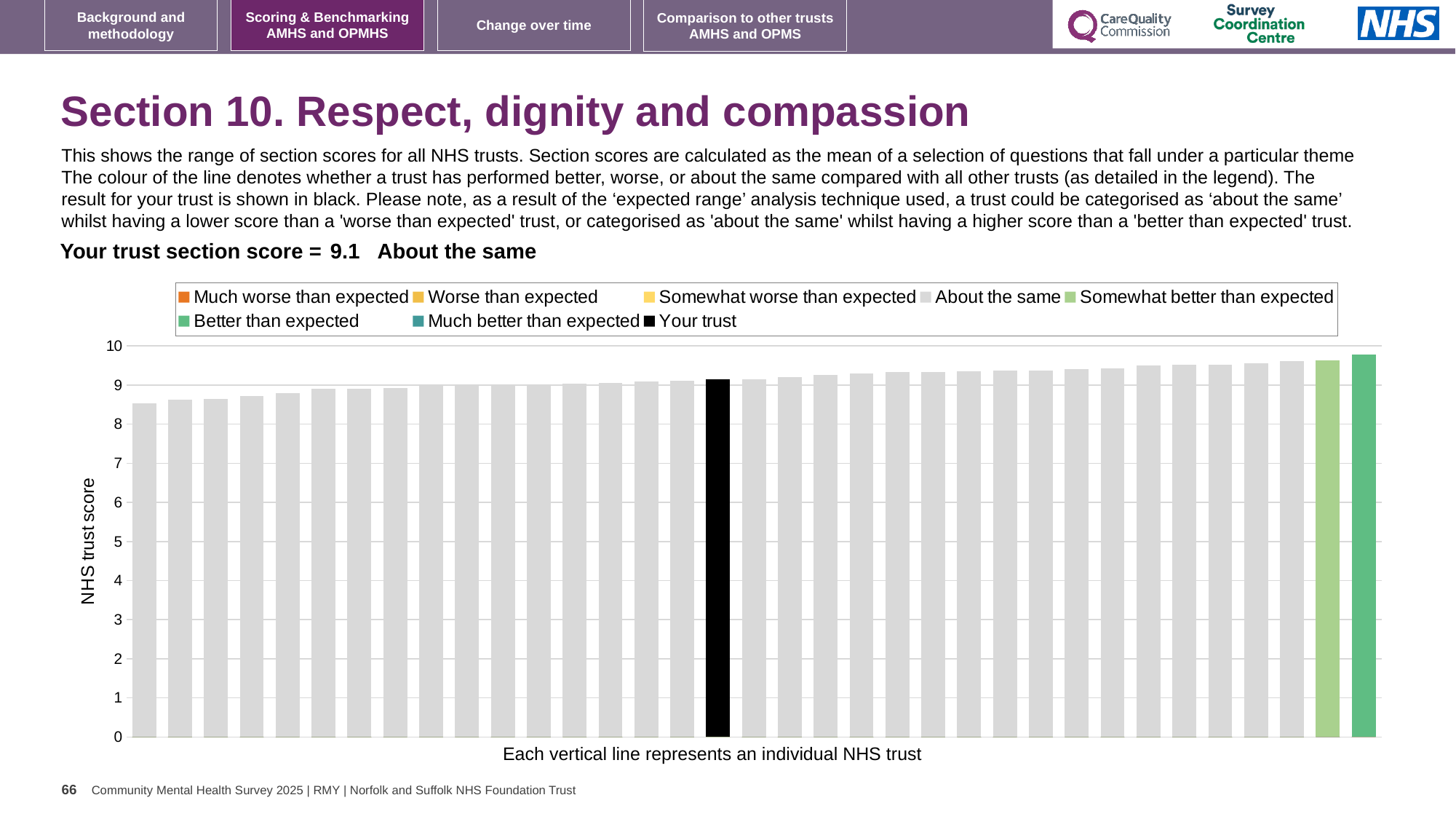
Is the value of the highest bar greater or less than 9? greater Is the value of the lowest bar greater or less than 9? less What is the section score for your trust shown on the slide? 9.1 How many bars on the chart are coloured green? 2 Do the bar values rise or fall from left to right along the x axis? rise What kind of chart is shown on the slide? bar chart Which performance category is your trust's section score placed in? About the same How many entries does the chart legend list? 8 What colour is the bar representing your trust? black Is the value of the lowest bar greater or less than 8? greater What is the label on the vertical axis of the chart? NHS trust score